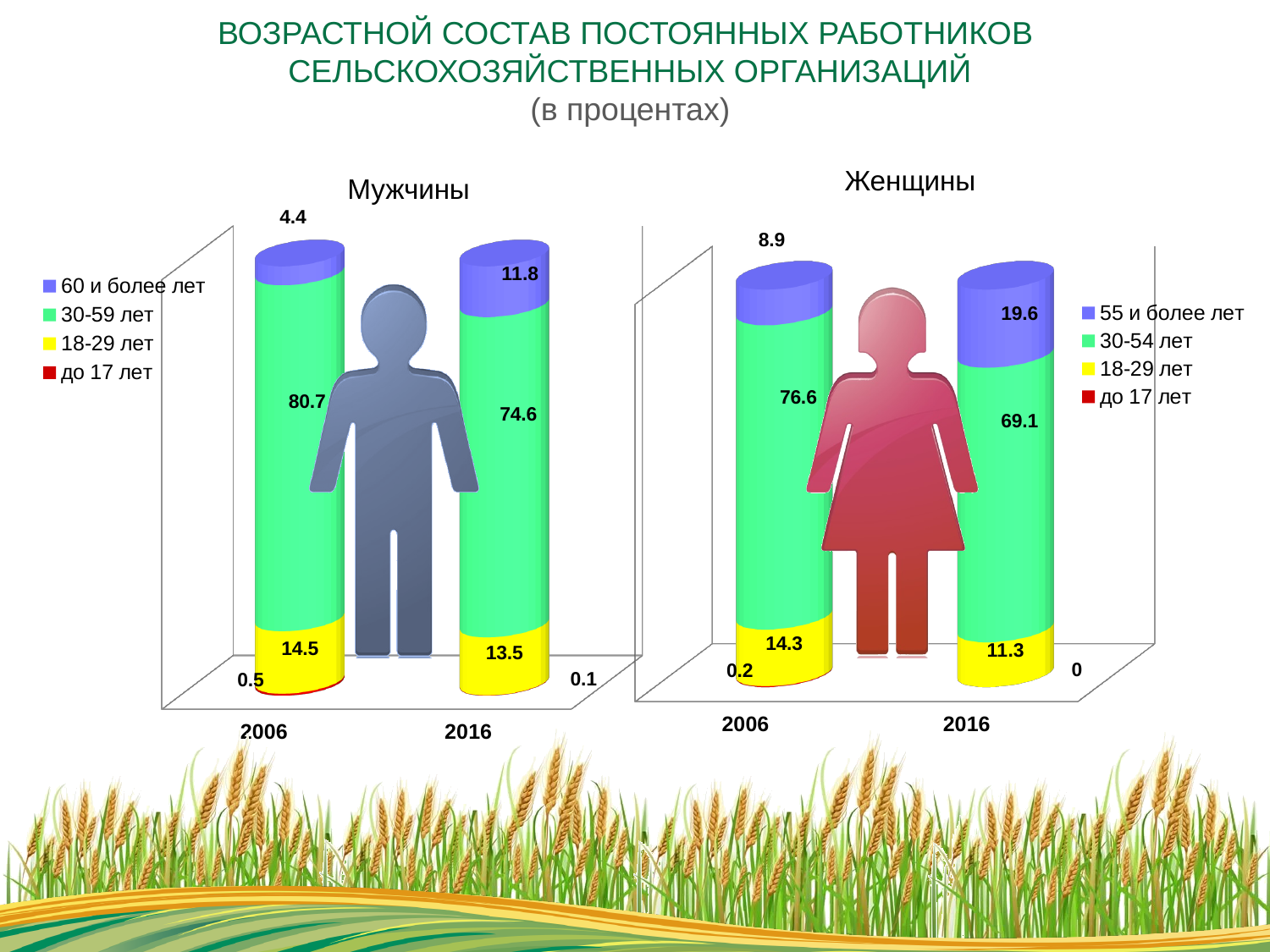
On the Мужчины chart, by how much did the 30-59 лет share fall from 2006 to 2016? 6.1 On the Мужчины chart, what is the value for 60 и более лет in 2016? 11.8 On the Женщины chart, which is larger: 30-54 лет in 2006 or in 2016? 2006 On the Мужчины chart, what is the value for 30-59 лет in 2006? 80.7 On the Женщины chart, what is the value for 18-29 лет in 2016? 11.3 On the Мужчины chart, which age group has the largest share in 2016? 30-59 лет On the Женщины chart, which age group has the smallest share in 2016? до 17 лет What kind of chart is the Мужчины chart? Stacked bar chart On the Женщины chart, by how much did the 55 и более лет share rise from 2006 to 2016? 10.7 On the Мужчины chart, what is the total of the stacked bar for 2016? 100 How many series does the legend of the Женщины chart list? 4 On the Женщины chart, what is the value for 55 и более лет in 2006? 8.9